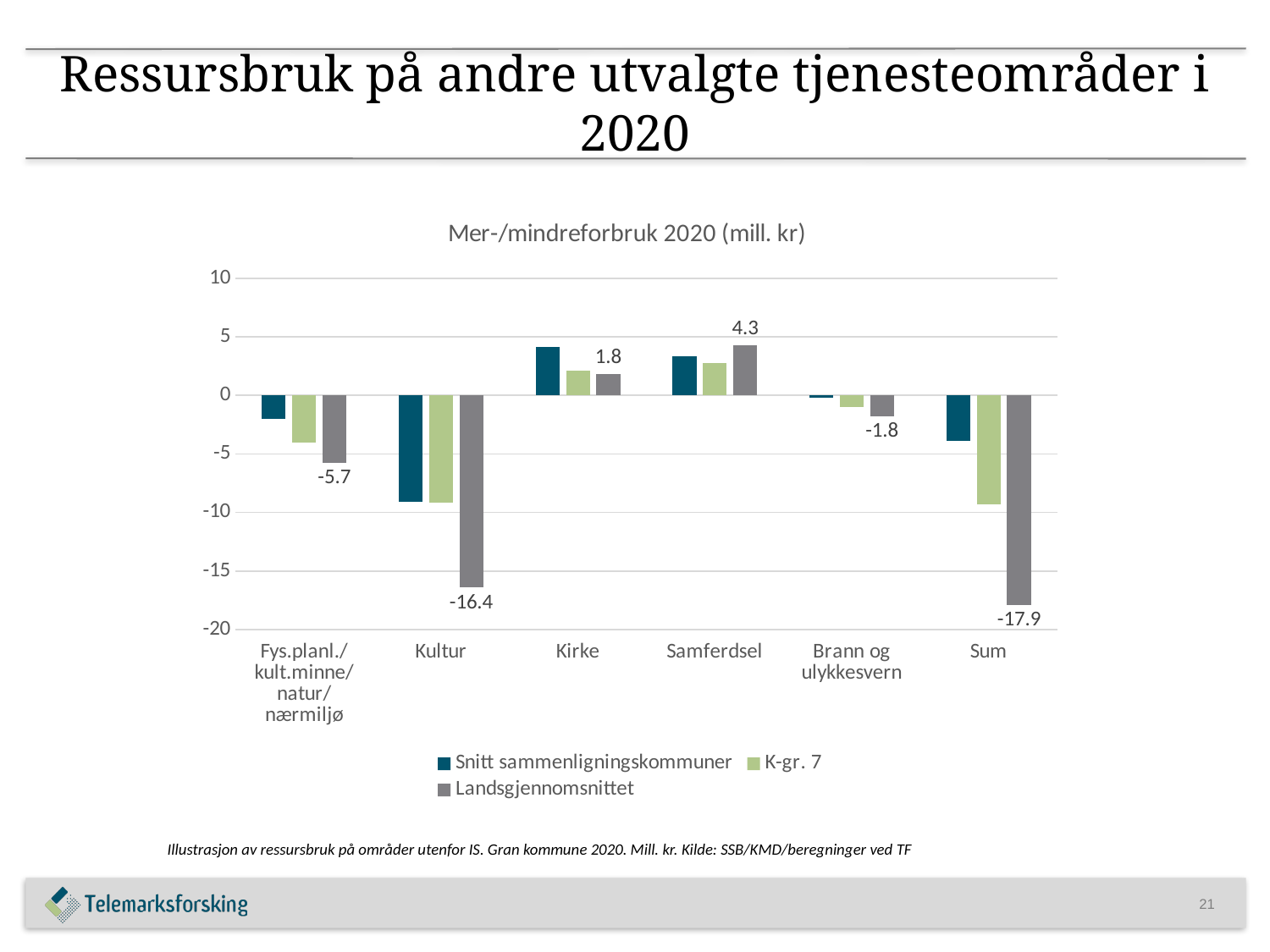
What kind of chart is shown on the slide? bar chart Is the value for Snitt sammenligningskommuner in the Kultur category greater or less than -5? less How many series does the legend list? 3 Which category has the lowest value for Landsgjennomsnittet? Sum How many categories are shown on the x axis? 6 Which category has the highest value for Landsgjennomsnittet? Samferdsel What is the value for Landsgjennomsnittet in the Samferdsel category? 4.3 What is the value for Landsgjennomsnittet in the Kultur category? -16.4 What is the value for Landsgjennomsnittet in the Kirke category? 1.8 Is the Landsgjennomsnittet value for Fys.planl./kult.minne/natur/nærmiljø larger or smaller than the Landsgjennomsnittet value for Brann og ulykkesvern? smaller What is the value for Landsgjennomsnittet in the Sum category? -17.9 What is the difference between the Landsgjennomsnittet values for Samferdsel and Kirke? 2.5